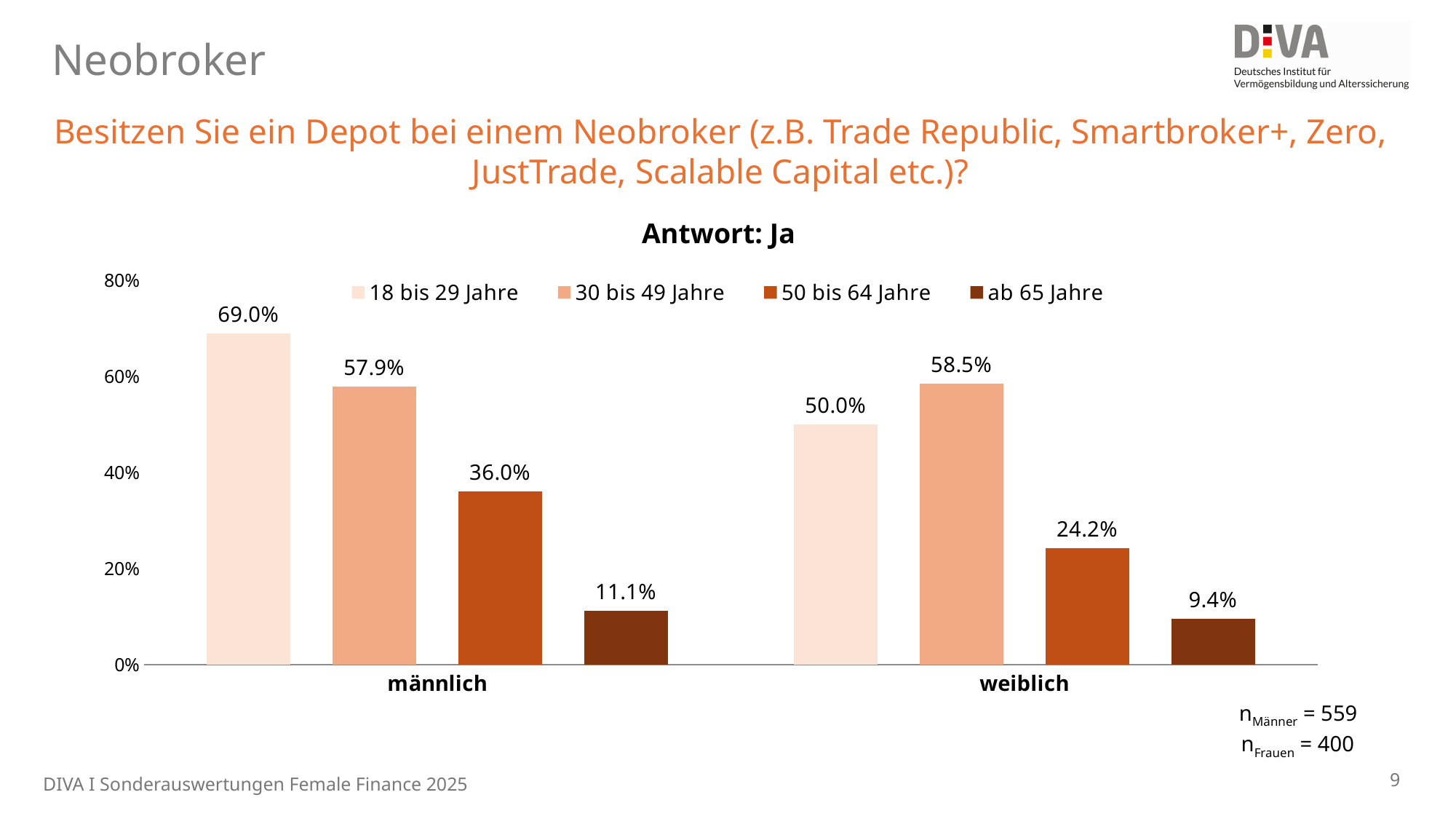
What is the value for the 18 bis 29 Jahre series in the männlich category? 69.0% Which age group has the highest value in the weiblich category? 30 bis 49 Jahre What is the difference between the 18 bis 29 Jahre values for männlich and weiblich? 19.0% What is the title shown above the chart? Antwort: Ja What is the value for the 50 bis 64 Jahre series in the weiblich category? 24.2% How many series does the legend list? 4 What is the value for the ab 65 Jahre series in the männlich category? 11.1% Which age group has the lowest value in the männlich category? ab 65 Jahre What is the value for the 30 bis 49 Jahre series in the weiblich category? 58.5% What kind of chart is shown on the slide? bar chart Which is larger: the 50 bis 64 Jahre value for männlich or for weiblich? männlich